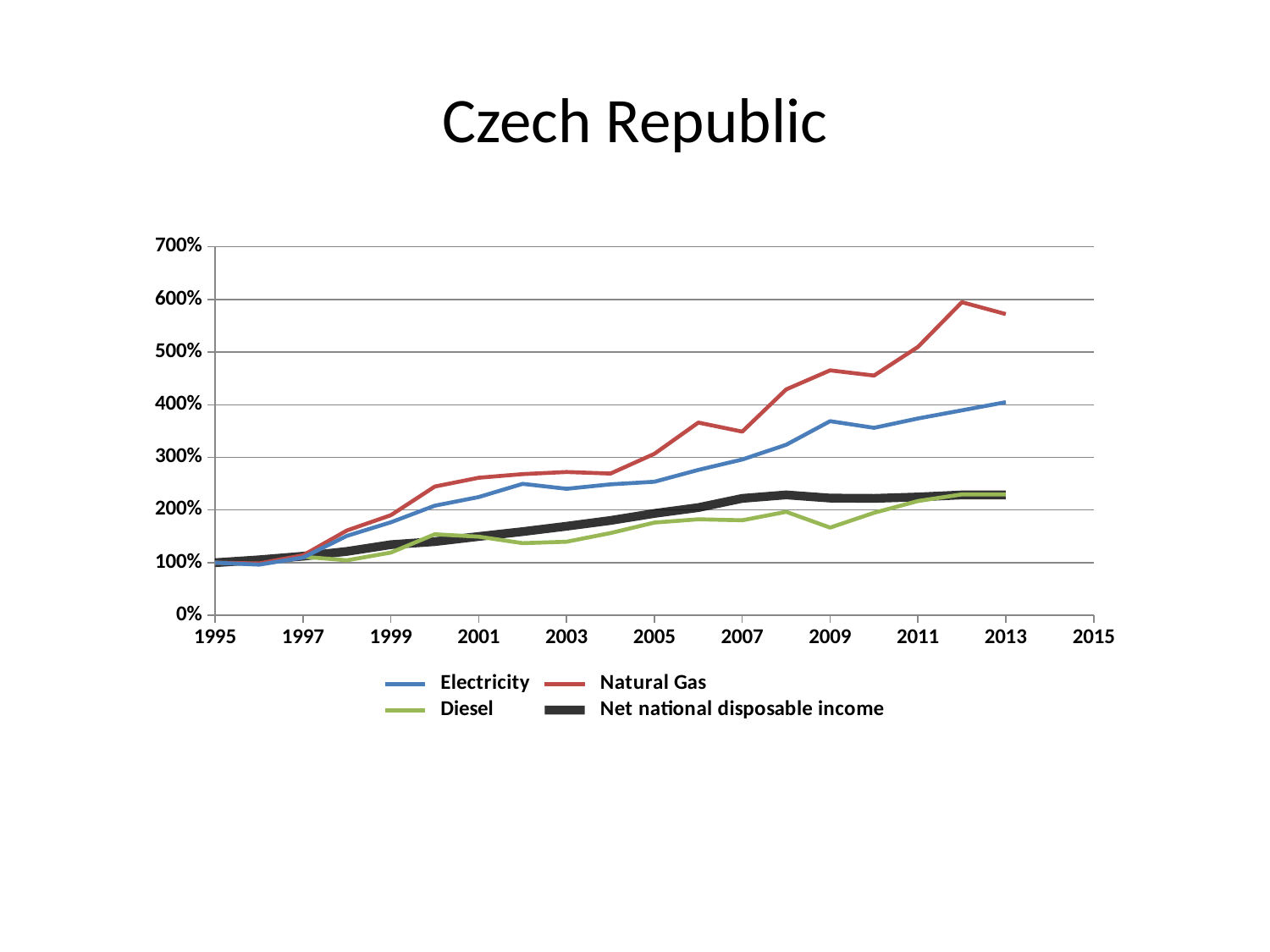
In 2008, which is larger: Natural Gas or Electricity? Natural Gas Does the Natural Gas series rise or fall overall from 1995 to 2013? rise Which series has the highest value in 2013? Natural Gas In 2005, which is larger: Diesel or Electricity? Electricity What is the title of the slide? Czech Republic How many series does the legend list? 4 What kind of chart is shown on the slide? line chart Is the value for Electricity in 2013 greater or less than 300%? greater Is the value for Natural Gas in 2012 greater or less than 500%? greater Which series has the lowest value in 2009? Diesel Is the value for Diesel in 2009 greater or less than 200%? less